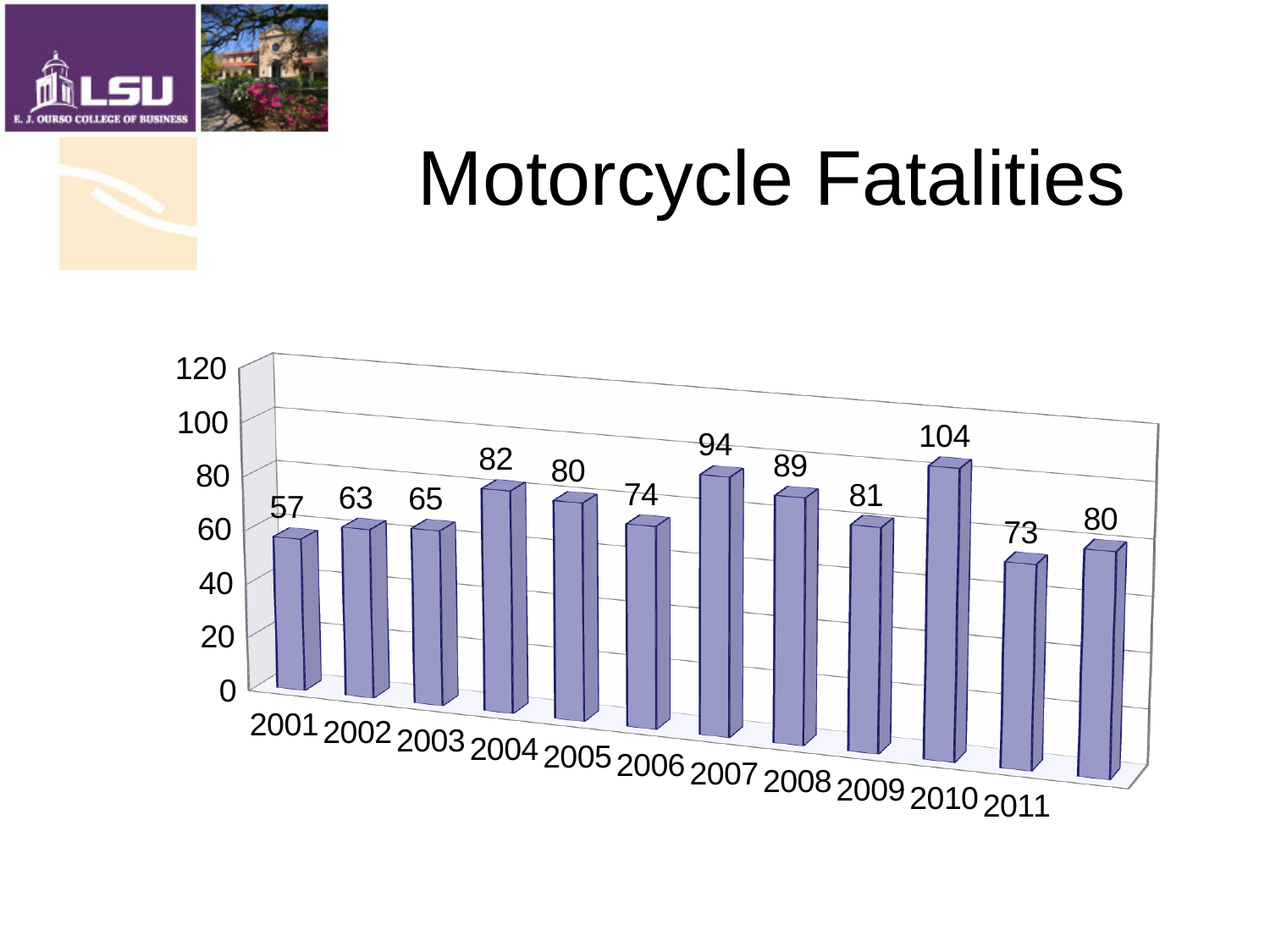
What kind of chart is shown on the slide? bar chart Which year has the lowest value? 2001 What is the value for 2001? 57 What is the title of the slide? Motorcycle Fatalities What is the difference between the values for 2007 and 2006? 20 What is the value for 2010? 104 How many years are shown on the x axis? 11 Is the value for 2010 greater or less than 100? greater What is the value for 2007? 94 Which is larger, the value for 2008 or the value for 2009? 2008 What is the difference between the values for 2010 and 2011? 31 Which year has the highest value? 2010